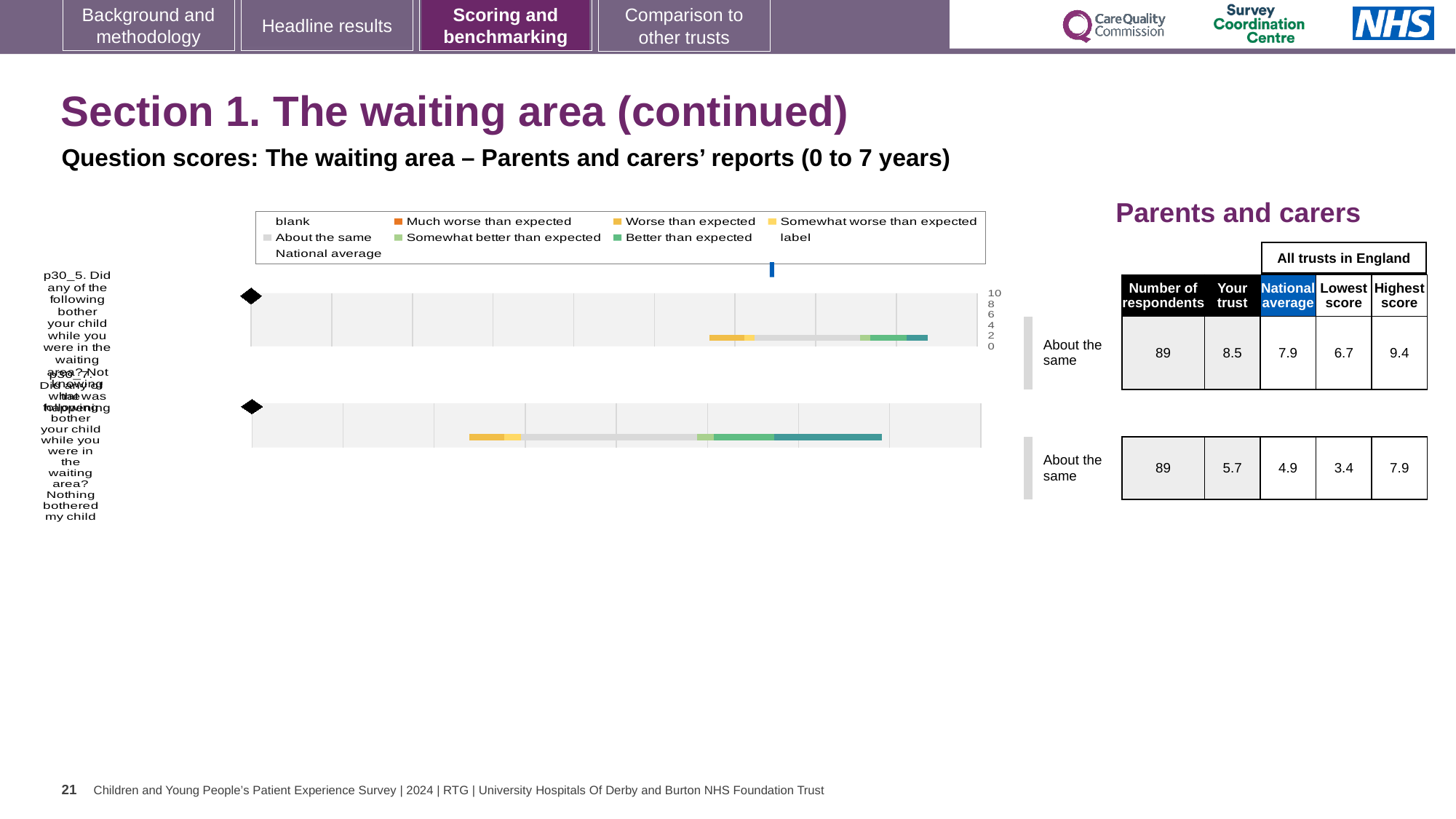
Which question has the higher 'Your trust' score, p30_5 or p30_7? p30_5 How many respondents answered question p30_7? 89 In the table beside the chart, what is the lowest score across all trusts in England for question p30_7? 3.4 What kind of chart is shown on the slide? Bar chart Which legend entry is shown in dark green? Better than expected In the table beside the chart, what is the 'Your trust' score for question p30_7 (Nothing bothered my child)? 5.7 By how much does the trust's score for p30_5 exceed the national average for that question? 0.6 How many questions (bars) are plotted in the chart? 2 What is the maximum value shown on the chart's axis? 10 In the table beside the chart, what is the 'Your trust' score for question p30_5 (Not knowing what was happening)? 8.5 In the table beside the chart, what is the national average for question p30_5? 7.9 In the table beside the chart, what is the highest score across all trusts in England for question p30_5? 9.4